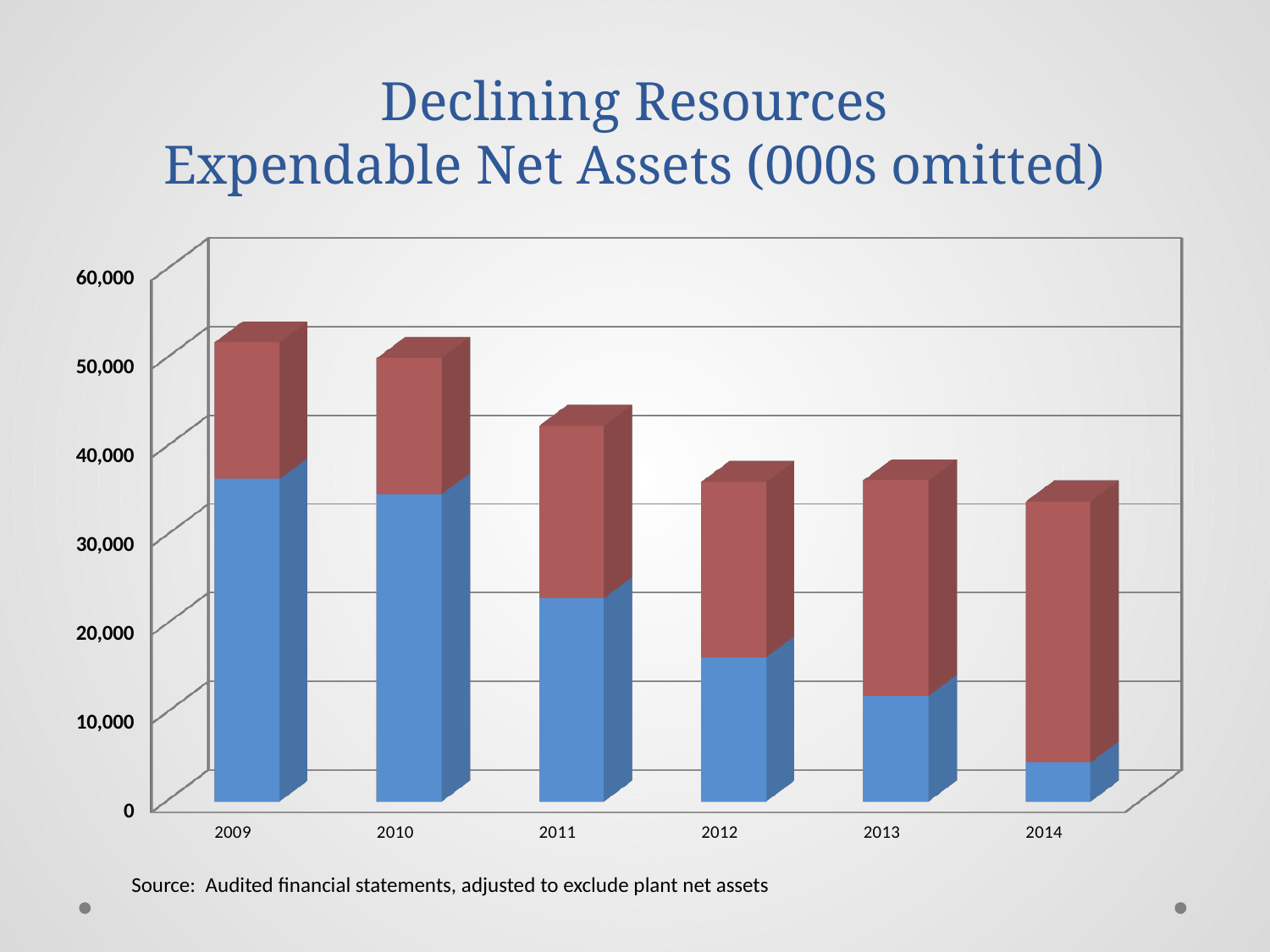
Do the total bar heights generally rise or fall from 2009 to 2014? Fall Is the blue segment for 2014 greater or less than 10,000? less Is the total bar for 2011 greater or less than 40,000? greater Is the total bar for 2012 greater or less than 40,000? less What kind of chart is shown on the slide? Stacked bar chart Which year has the tallest total bar? 2009 How many years are shown on the x axis of the chart? 6 Which is larger, the total bar for 2010 or the total bar for 2012? 2010 Which year has the smallest blue segment? 2014